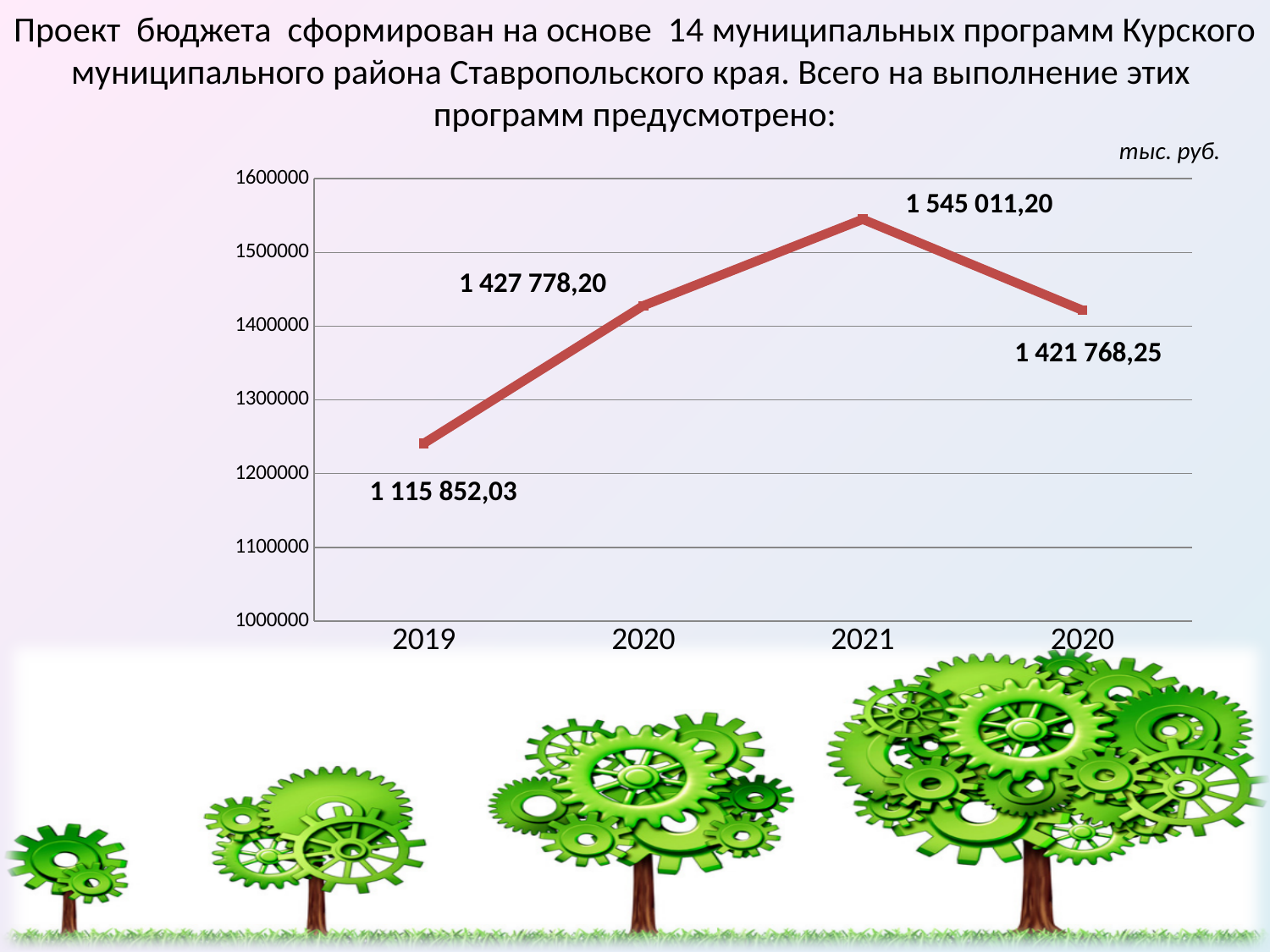
Which year has the highest value on the chart? 2021 Which year has the lowest value on the chart? 2019 Do the values rise or fall from 2019 to 2021? rise What is the difference between the value for 2021 and the value for 2019? 429 159,17 What unit is indicated above the chart? тыс. руб. What type of chart is shown on the slide? line chart Is the value for 2021 greater or less than 1500000? greater What is the value shown for the last point on the x axis (the second label reading 2020)? 1 421 768,25 What is the value shown for the second point on the x axis (the first label reading 2020)? 1 427 778,20 How many data points are plotted on the line chart? 4 What is the value shown for 2021? 1 545 011,20 What is the value shown for 2019? 1 115 852,03